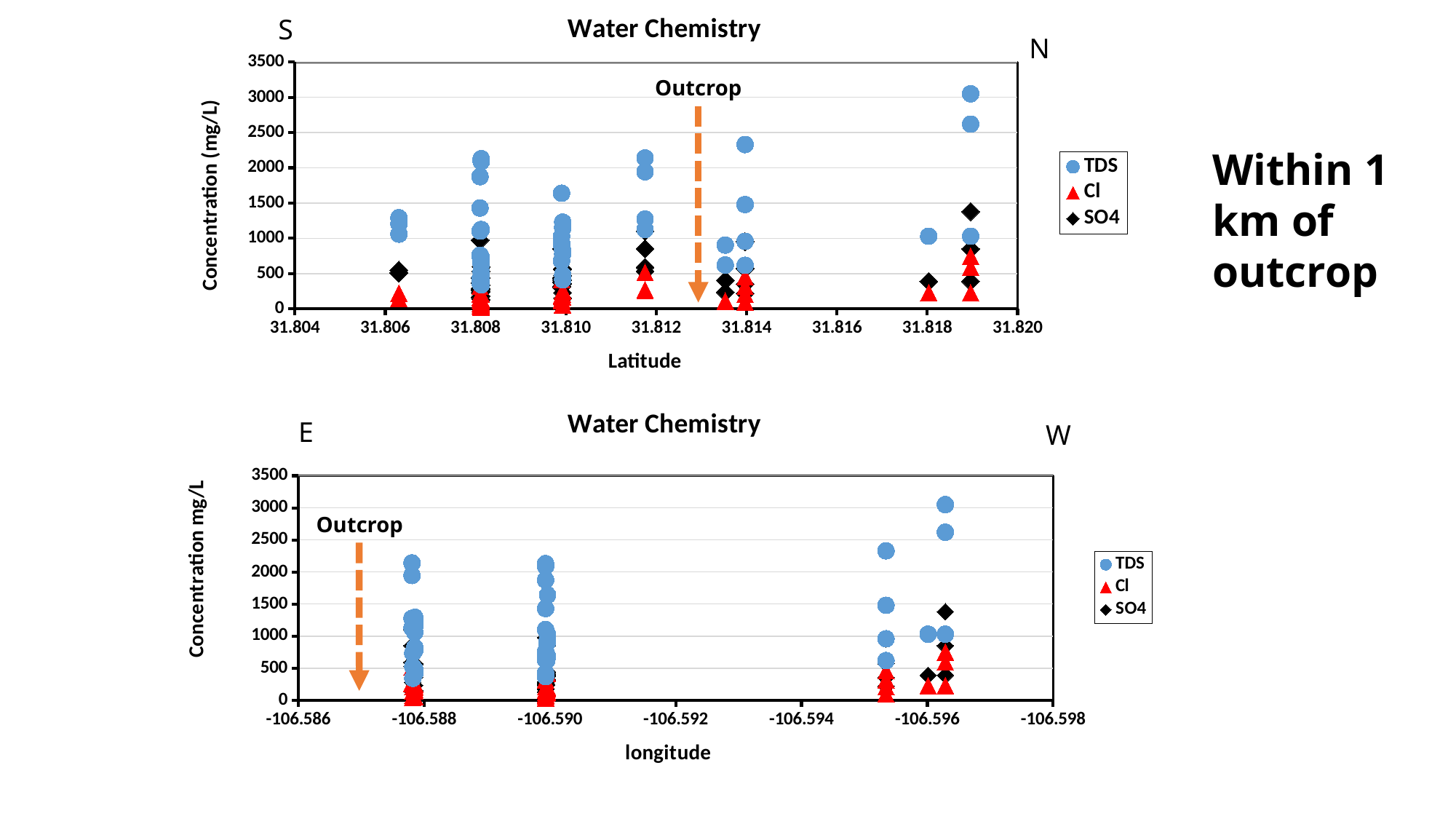
What kind of chart is the top chart on the slide? scatter chart In the top chart, which series reaches the highest concentration, TDS or Cl? TDS In the top chart, is the highest SO4 value greater or less than 1000? greater How many series does the legend of the bottom chart list? 3 What kind of chart is the bottom chart on the slide? scatter chart In the bottom chart, which series reaches the highest concentration, SO4 or TDS? TDS What is the title of the top chart? Water Chemistry How many series does the legend of the top chart list? 3 In the top chart, is the highest TDS value greater or less than 3000? greater What is the x-axis label of the bottom chart? longitude In the bottom chart, is the highest TDS value greater or less than 3000? greater